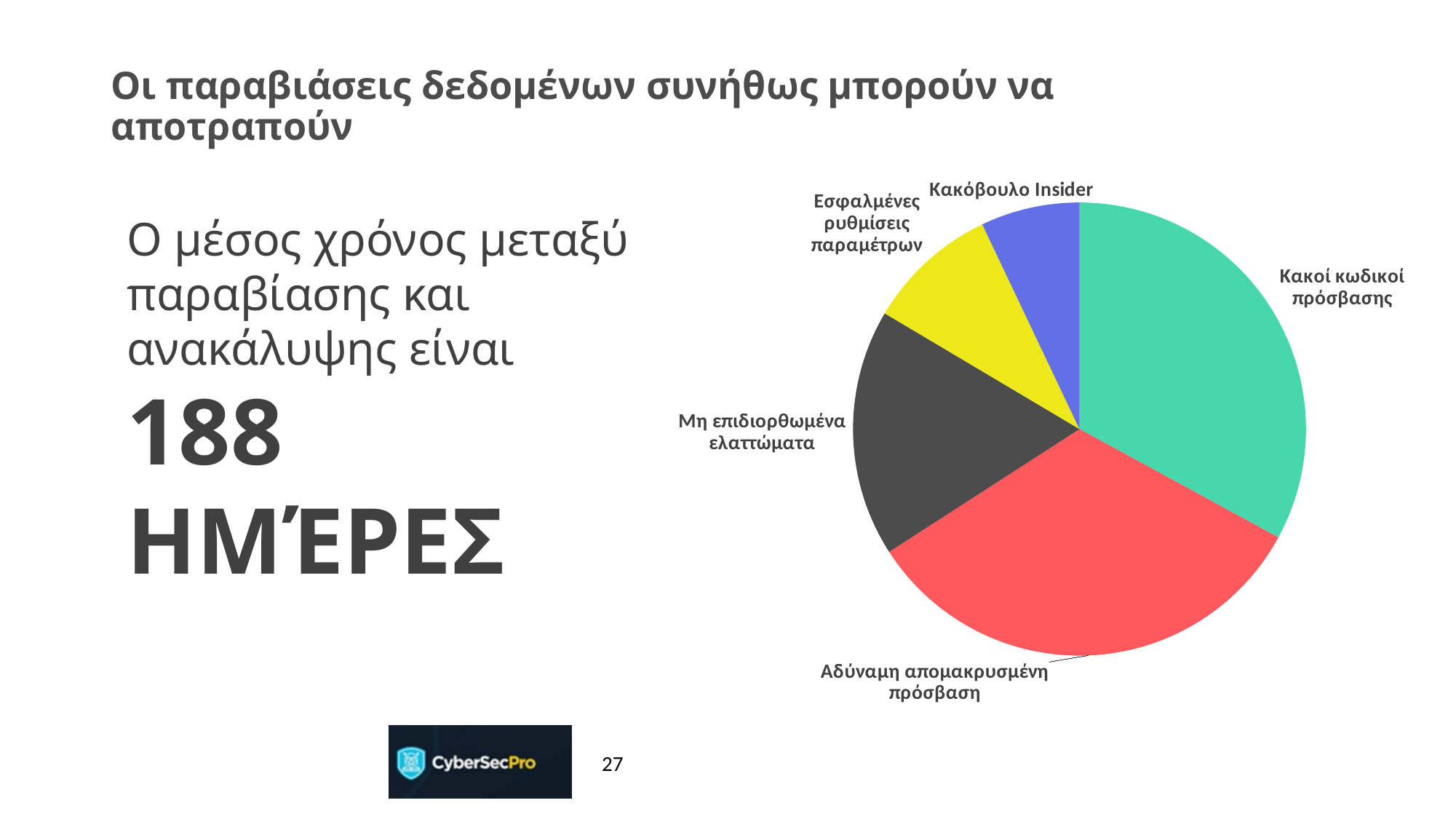
Which category is shown by the red slice of the pie chart? Αδύναμη απομακρυσμένη πρόσβαση Which slice of the pie chart is the smallest? Κακόβουλο Insider Which slice is larger: Μη επιδιορθωμένα ελαττώματα or Εσφαλμένες ρυθμίσεις παραμέτρων? Μη επιδιορθωμένα ελαττώματα Which slice is larger: Αδύναμη απομακρυσμένη πρόσβαση or Κακόβουλο Insider? Αδύναμη απομακρυσμένη πρόσβαση How many slices does the pie chart have? 5 Which slice is larger: Κακοί κωδικοί πρόσβασης or Μη επιδιορθωμένα ελαττώματα? Κακοί κωδικοί πρόσβασης What colour is the Κακόβουλο Insider slice in the pie chart? blue What kind of chart is shown on the slide? pie chart